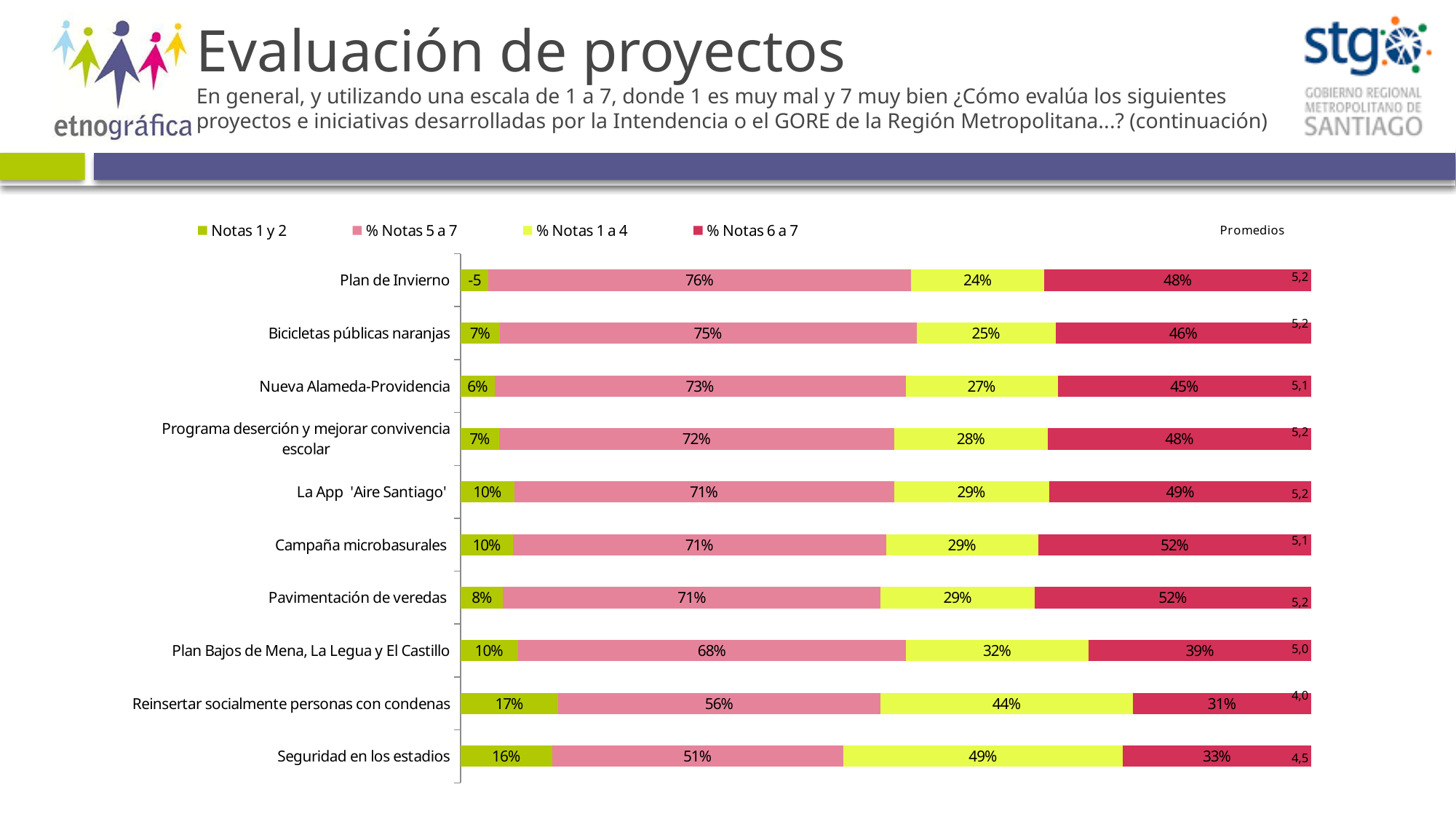
Which project has the highest '% Notas 1 a 4' value? Seguridad en los estadios What is the '% Notas 5 a 7' value for Plan de Invierno? 76% What is the 'Promedios' value shown for Reinsertar socialmente personas con condenas? 4,0 What kind of chart is shown on the slide? Stacked bar chart Which project has the lowest '% Notas 5 a 7' value? Seguridad en los estadios What is the difference between the '% Notas 5 a 7' values for Plan de Invierno and Seguridad en los estadios? 25% What is the 'Notas 1 y 2' value for Reinsertar socialmente personas con condenas? 17% What is the '% Notas 1 a 4' value for Seguridad en los estadios? 49% How many projects (categories) are listed on the chart? 10 Which has a larger '% Notas 6 a 7' value, Plan Bajos de Mena, La Legua y El Castillo or La App 'Aire Santiago'? La App 'Aire Santiago' What is the '% Notas 6 a 7' value for Campaña microbasurales? 52% How many series does the chart legend list? 4